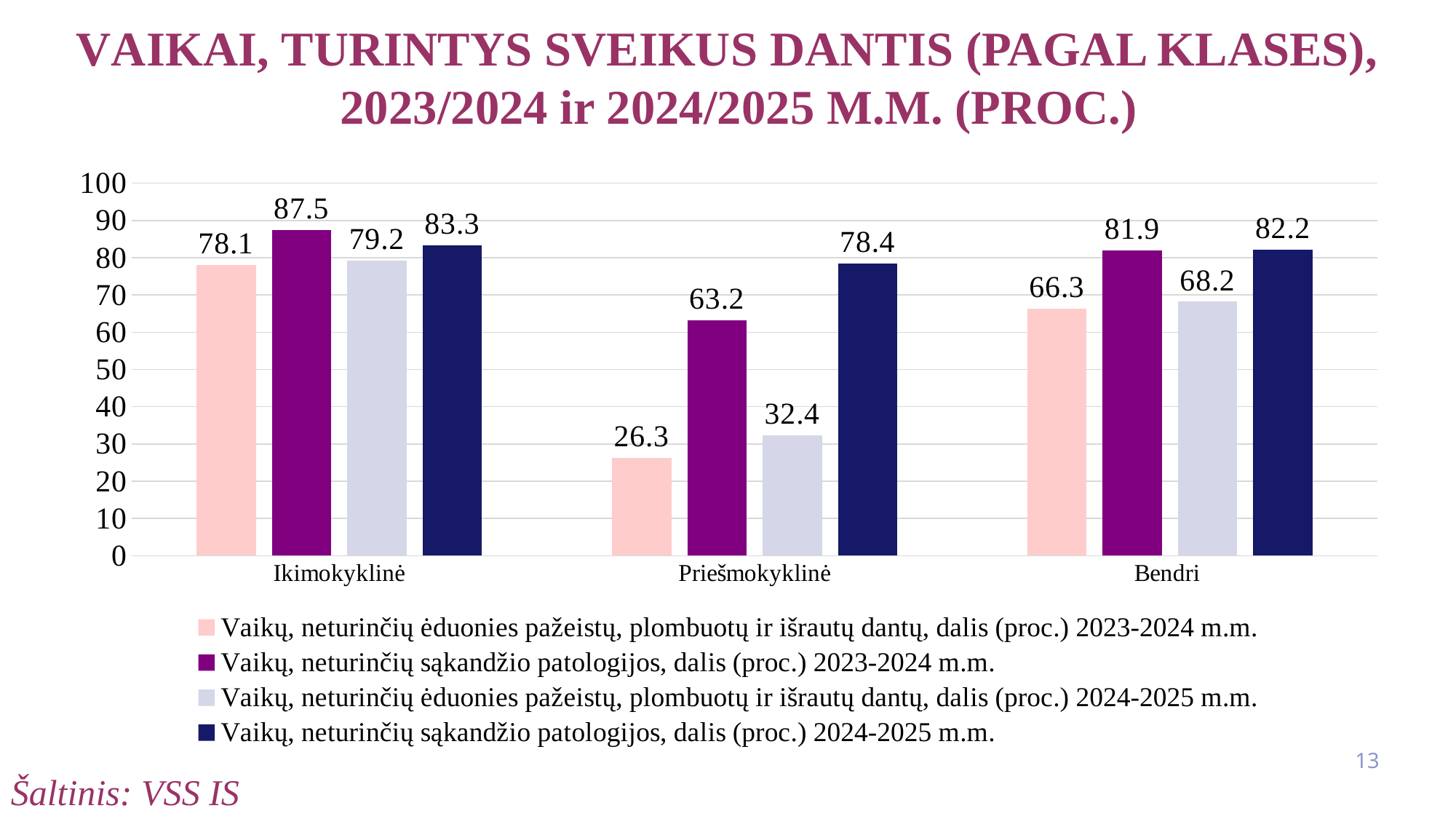
Which category has the lowest value in the series 'Vaikų, neturinčių ėduonies pažeistų, plombuotų ir išrautų dantų, dalis (proc.) 2024-2025 m.m.'? Priešmokyklinė What kind of chart is shown on the slide? bar chart What is the difference between the 2024-2025 and 2023-2024 values for Priešmokyklinė in the 'neturinčių sąkandžio patologijos' series? 15.2 How many categories are shown on the x axis? 3 What source is cited at the bottom of the slide? VSS IS What is the value for Priešmokyklinė in the series 'Vaikų, neturinčių ėduonies pažeistų, plombuotų ir išrautų dantų, dalis (proc.) 2023-2024 m.m.'? 26.3 How many series does the legend list? 4 Is the value for Priešmokyklinė in the series 'Vaikų, neturinčių ėduonies pažeistų, plombuotų ir išrautų dantų, dalis (proc.) 2024-2025 m.m.' greater or less than 40? less For Bendri, which is larger: the 'neturinčių ėduonies pažeistų, plombuotų ir išrautų dantų' value for 2023-2024 or for 2024-2025? 2024-2025 (68.2) What is the value for Ikimokyklinė in the series 'Vaikų, neturinčių sąkandžio patologijos, dalis (proc.) 2023-2024 m.m.'? 87.5 Which category has the highest value in the series 'Vaikų, neturinčių sąkandžio patologijos, dalis (proc.) 2023-2024 m.m.'? Ikimokyklinė What is the value for Bendri in the series 'Vaikų, neturinčių sąkandžio patologijos, dalis (proc.) 2024-2025 m.m.'? 82.2